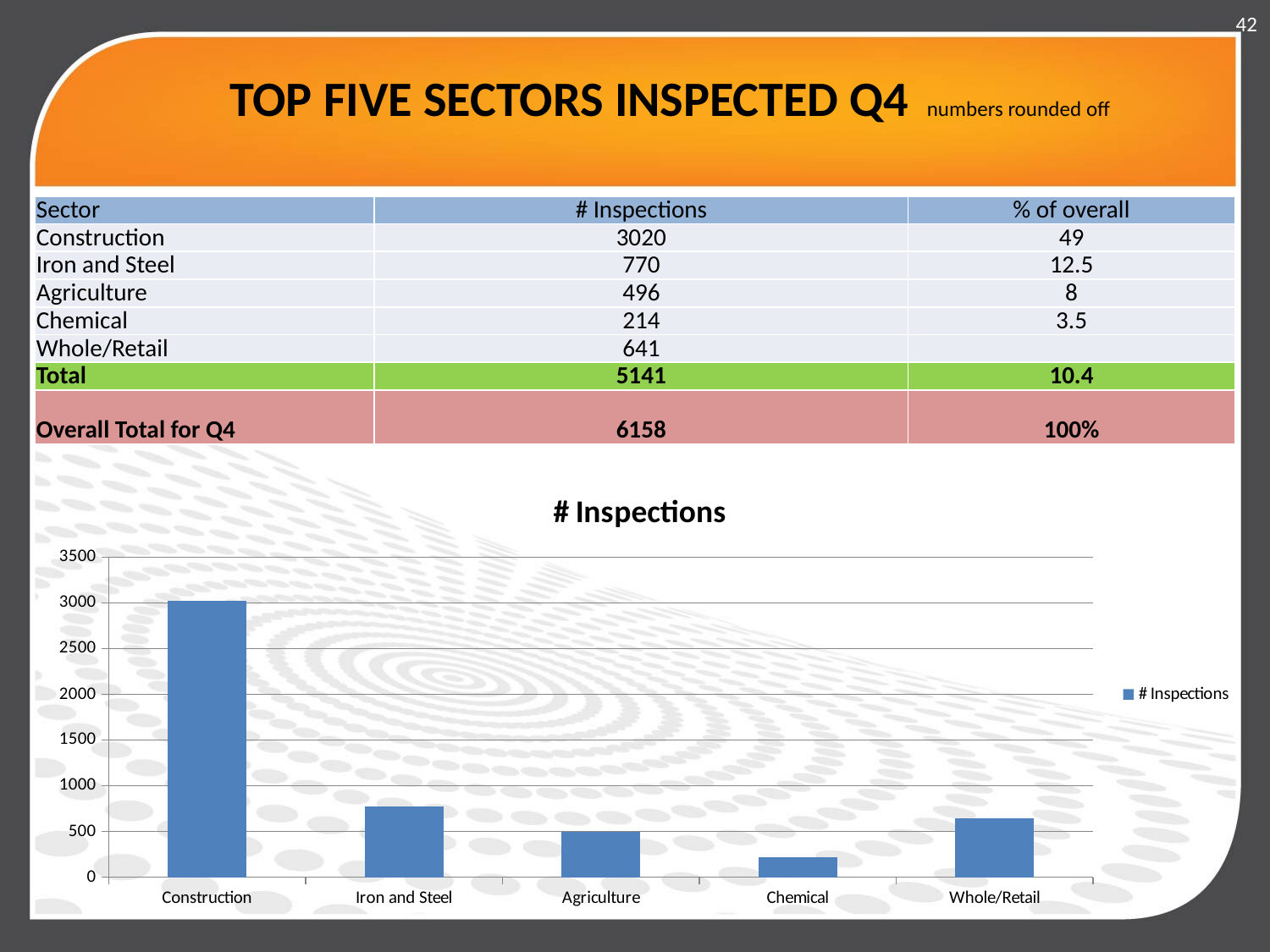
Is the value for Chemical greater or less than 500? less What kind of chart is shown on the slide? bar chart How many sectors are plotted on the x axis of the chart? 5 Which has more inspections, Whole/Retail or Agriculture? Whole/Retail According to the slide, how many inspections were there for Iron and Steel? 770 Is the value for Iron and Steel greater or less than 1000? less What is the difference in inspections between Construction and Whole/Retail, using the values printed on the slide? 2379 How many series does the chart legend list? 1 What is the title of the chart? # Inspections Which sector has the highest number of inspections in the chart? Construction Is the value for Construction greater or less than 3000? greater Which sector has the lowest number of inspections in the chart? Chemical